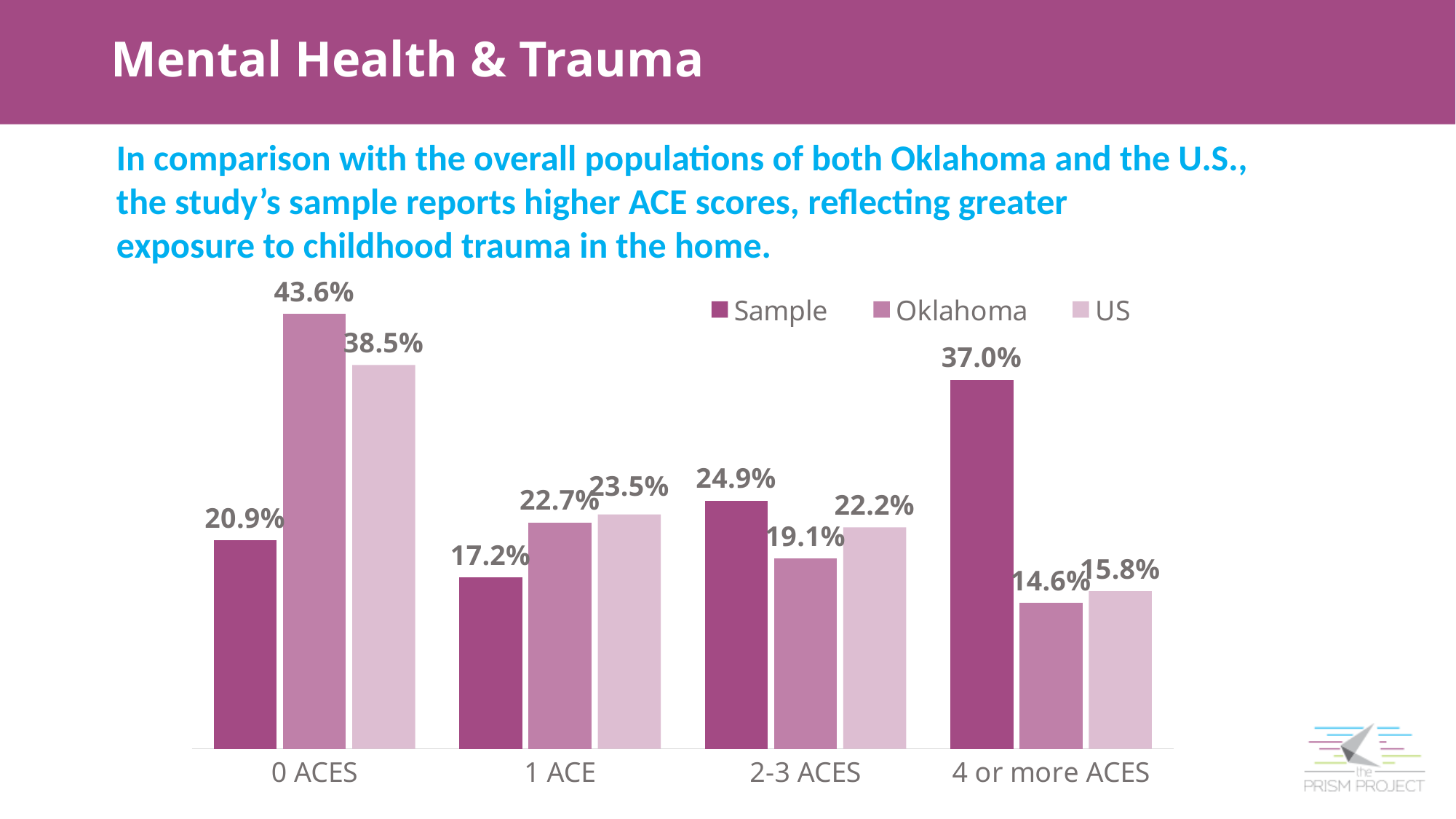
What is the value for Sample in the 0 ACES category? 20.9% What are the three series listed in the legend? Sample, Oklahoma, US How many series does the legend list? 3 What is the value for Oklahoma in the 4 or more ACES category? 14.6% Which is larger in the 2-3 ACES category, the Sample value or the Oklahoma value? Sample What kind of chart is shown on the slide? Bar chart What is the difference between the Sample and US values in the 4 or more ACES category? 21.2% Which category has the lowest value for the Oklahoma series? 4 or more ACES Which category has the highest value for the Sample series? 4 or more ACES Do the Oklahoma values rise or fall from 0 ACES to 4 or more ACES? Fall What is the value for US in the 1 ACE category? 23.5% How many categories are shown on the x axis? 4